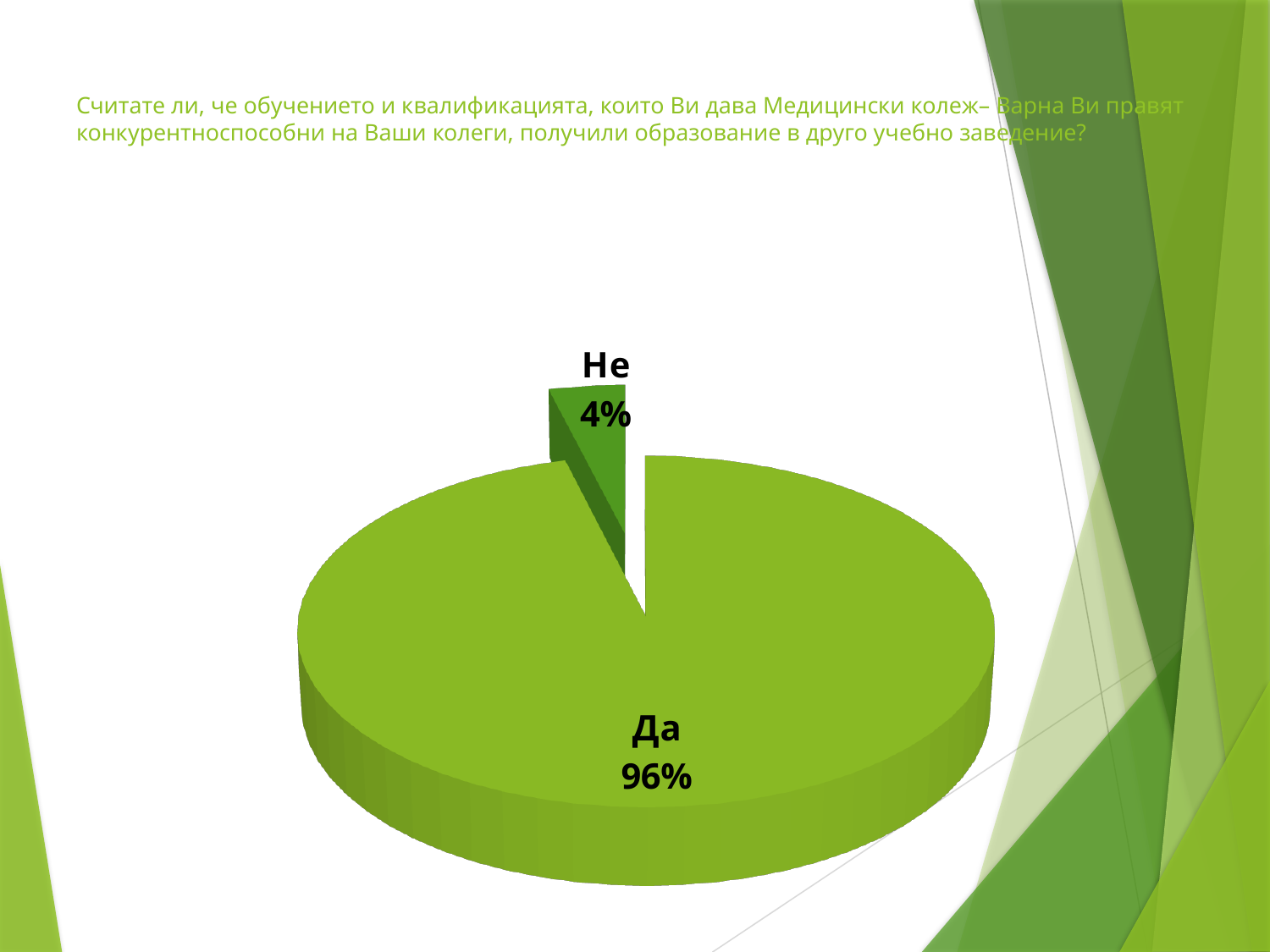
How many slices does the pie chart have? 2 What percentage of respondents answered "Да"? 96% Which answer has the largest share of the pie? Да Which slice is pulled out (exploded) from the pie? Не What is the difference in percentage points between the "Да" and "Не" slices? 92 Which answer has the smallest share of the pie? Не Is the share for "Да" greater or less than 50%? greater Which slice is larger, "Да" or "Не"? Да What percentage of respondents answered "Не"? 4% What share of the pie does the "Не" slice represent? 4% What kind of chart is shown on the slide? Pie chart